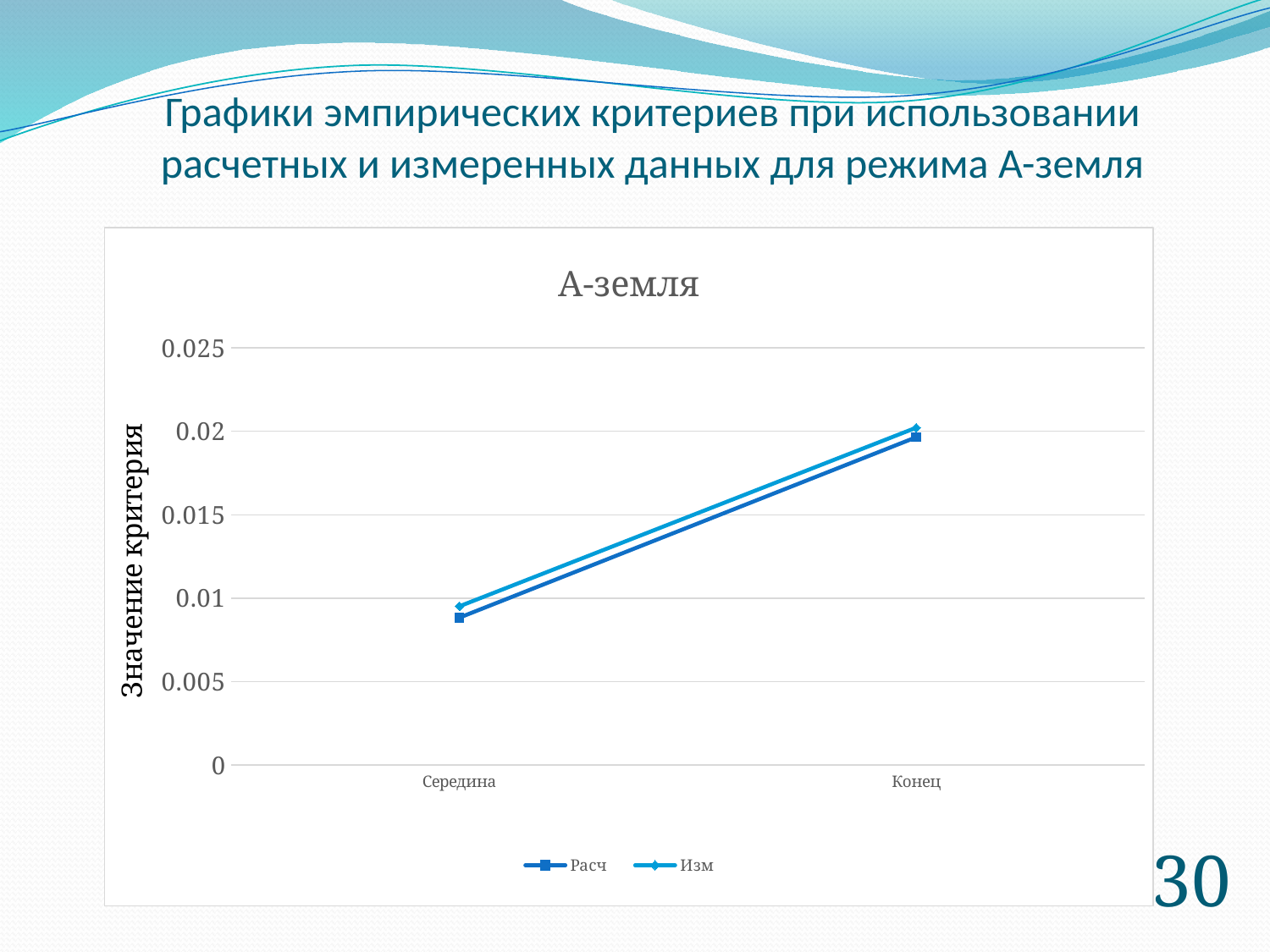
What is the title of the chart? А-земля Do the values of the Расч series rise or fall from Середина to Конец? rise For the Изм series, which category has the highest value? Конец How many series does the legend list? 2 For the Расч series, which is larger: the value at Середина or at Конец? Конец Is the value for Изм at Конец greater or less than 0.015? greater Is the value for Расч at Конец greater or less than 0.015? greater What kind of chart is shown on the slide? line chart How many categories are on the x axis? 2 Is the value for Расч at Середина greater or less than 0.01? less Do the values of the Изм series rise or fall from Середина to Конец? rise What is the label of the vertical axis? Значение критерия